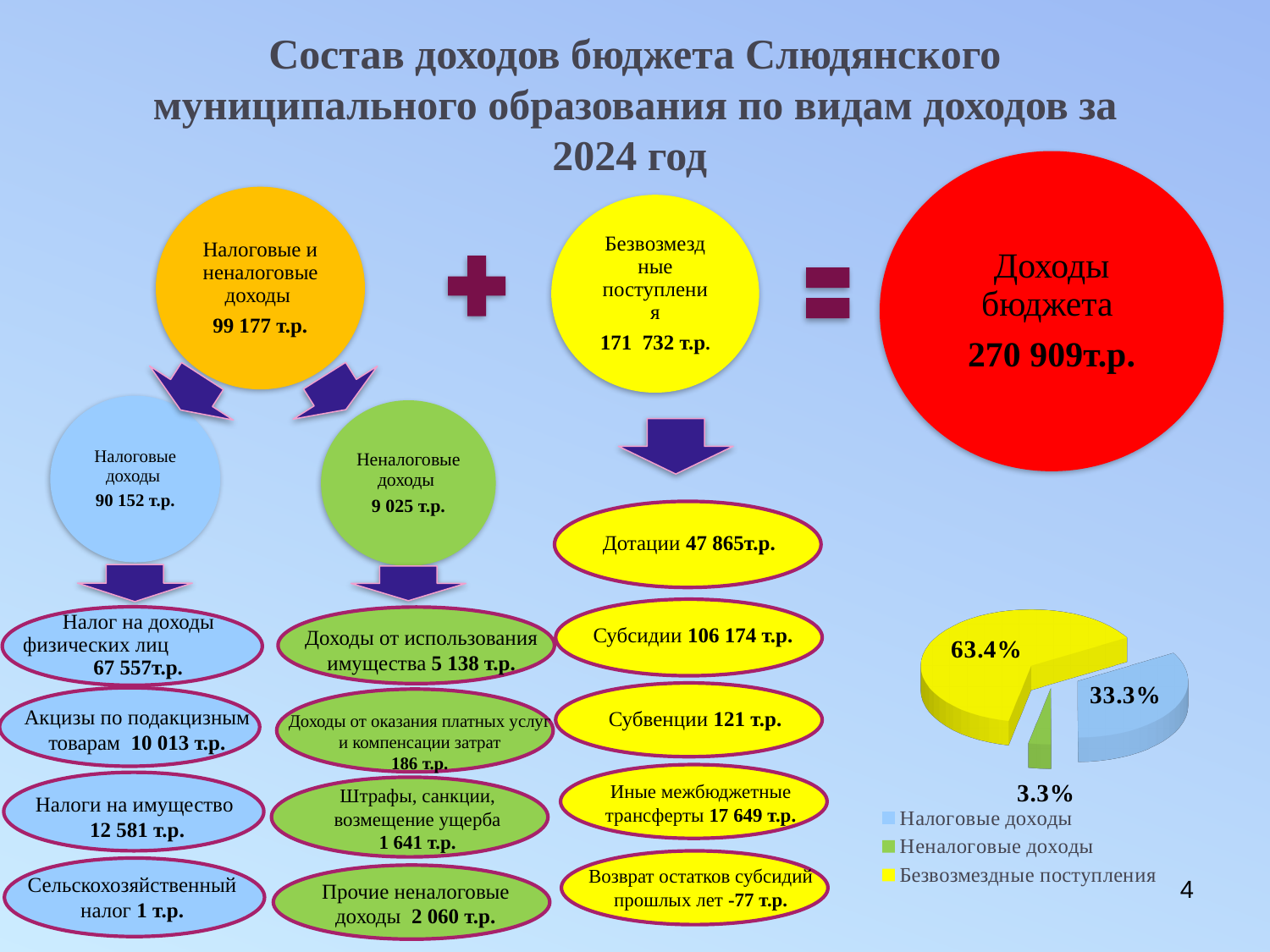
What colour is the Безвозмездные поступления slice in the pie chart? yellow In the pie chart, what share is shown for Налоговые доходы? 33.3% What kind of chart is shown in the bottom right of the slide? pie chart What colour is the Неналоговые доходы slice in the pie chart? green In the pie chart, which is larger: the share of Налоговые доходы or the share of Неналоговые доходы? Налоговые доходы In the pie chart, what is the difference between the shares of Безвозмездные поступления and Налоговые доходы? 30.1% How many entries does the pie chart legend list? 3 Which category has the largest slice in the pie chart? Безвозмездные поступления In the pie chart, what share is shown for Неналоговые доходы? 3.3% In the pie chart, what share is shown for Безвозмездные поступления? 63.4% Which category has the smallest slice in the pie chart? Неналоговые доходы How many slices does the pie chart have? 3